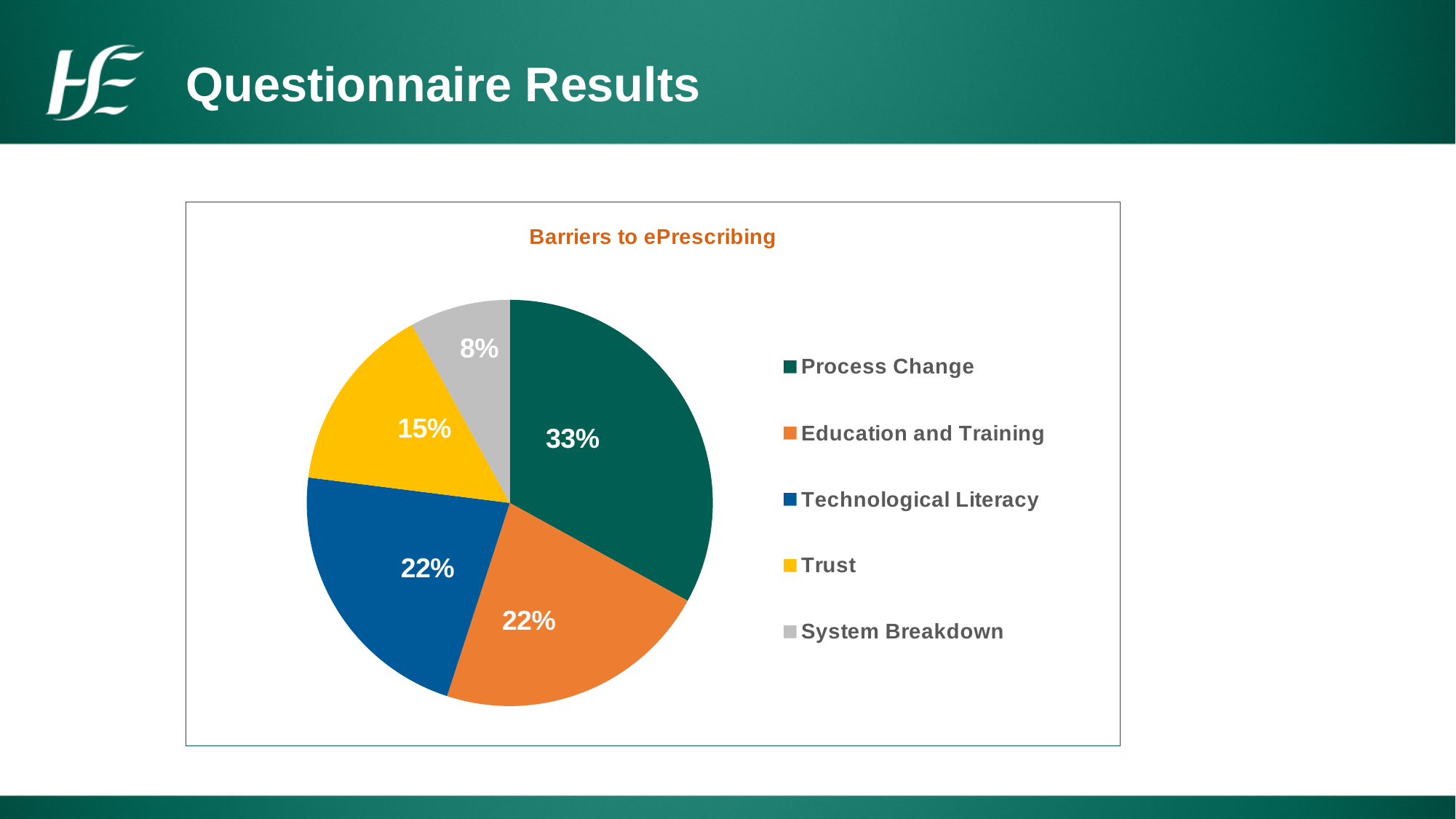
Which is larger, the slice for Trust or the slice for System Breakdown? Trust What is the difference in percentage points between Process Change and Trust? 18 Which category has the largest slice of the pie? Process Change What share of the pie does Process Change represent? 33% What share of the pie does Technological Literacy represent? 22% What is the title of the chart? Barriers to ePrescribing Which category has the smallest slice of the pie? System Breakdown How many categories are shown in the pie chart? 5 What share of the pie does System Breakdown represent? 8% What type of chart is shown on the slide? pie chart Which colour represents Education and Training in the legend? orange